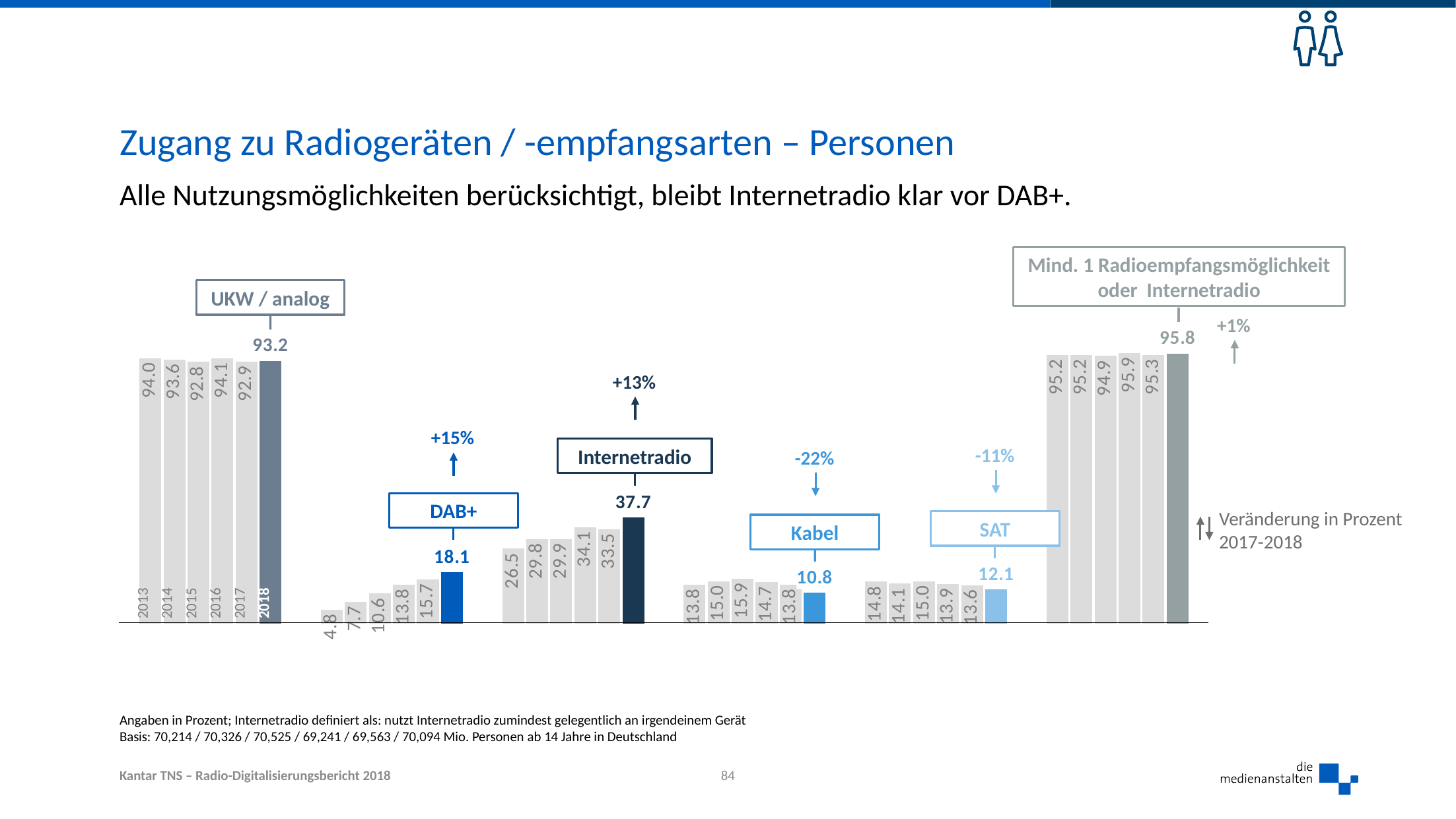
What is the 2013 value for DAB+? 4.8 Do the DAB+ values rise or fall from 2013 to 2018? rise What is the 2016 value for UKW / analog? 94.1 What is the 2018 value for DAB+? 18.1 What is the 2018 value for Internetradio? 37.7 What percentage change from 2017 to 2018 is shown for SAT? -11% What is the difference between the 2018 values for Internetradio and DAB+? 19.6 How many years are shown for each group in the chart? 6 What is the 2018 value for Kabel? 10.8 Which year has the highest value in the Internetradio group? 2018 Which year has the lowest value in the Kabel group? 2018 Which is larger in 2018, the value for SAT or the value for Kabel? SAT